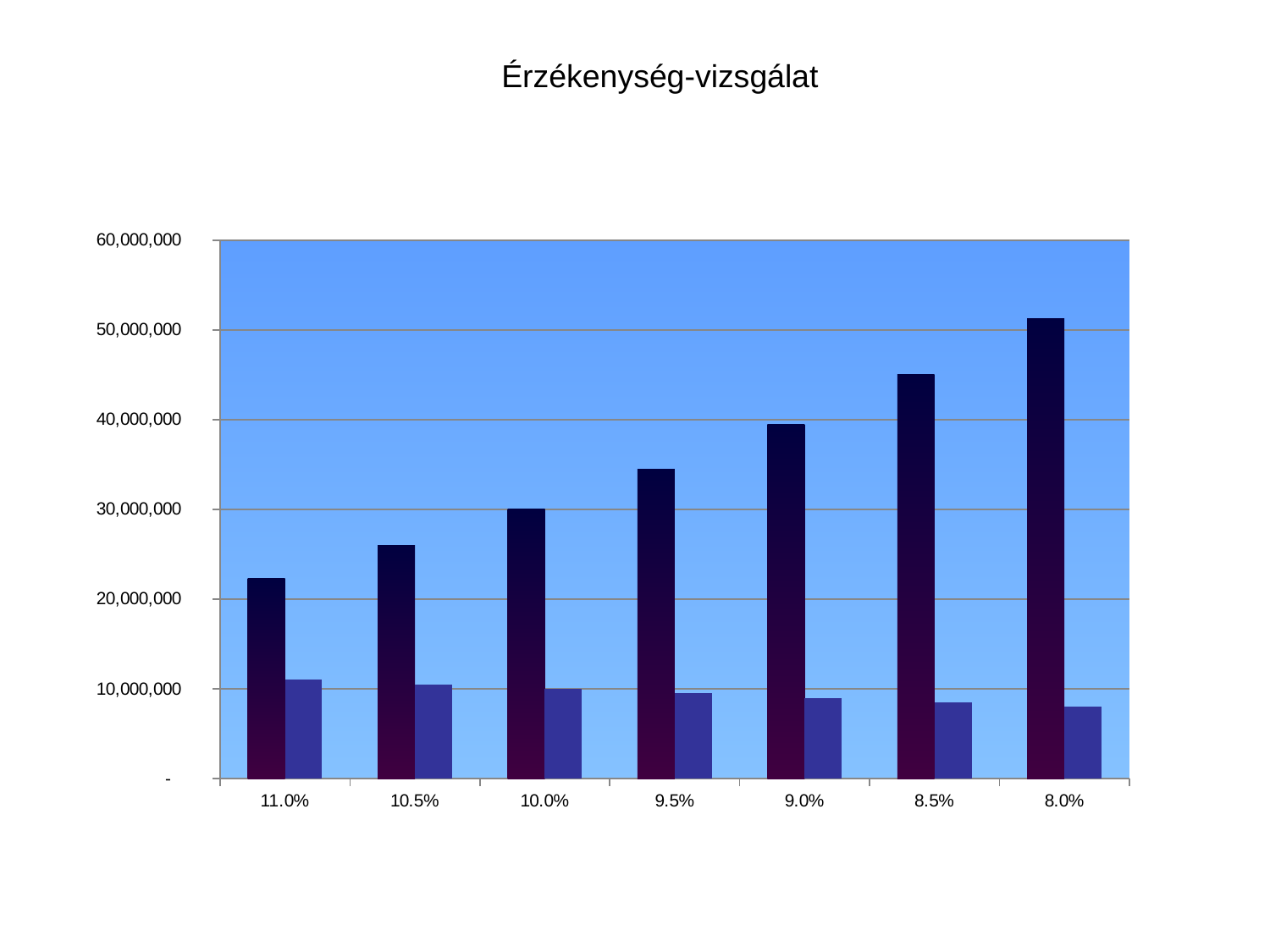
How many categories are shown on the x axis? 7 Is the value of the dark bar for 11.0% greater or less than 20,000,000? greater Is the value of the blue bar for 8.0% greater or less than 10,000,000? less Which is larger: the blue bar for 11.0% or the blue bar for 8.0%? 11.0% How many bars are plotted for each category on the x axis? 2 What kind of chart is shown on the slide? bar chart For which category is the dark (taller) bar highest? 8.0% Do the values of the dark (taller) bars rise or fall from 11.0% to 8.0% along the x axis? rise Do the values of the blue (shorter) bars rise or fall from 11.0% to 8.0% along the x axis? fall What is the title of the chart? Érzékenység-vizsgálat Is the value of the dark bar for 8.5% greater or less than 40,000,000? greater For which category is the dark (taller) bar lowest? 11.0%